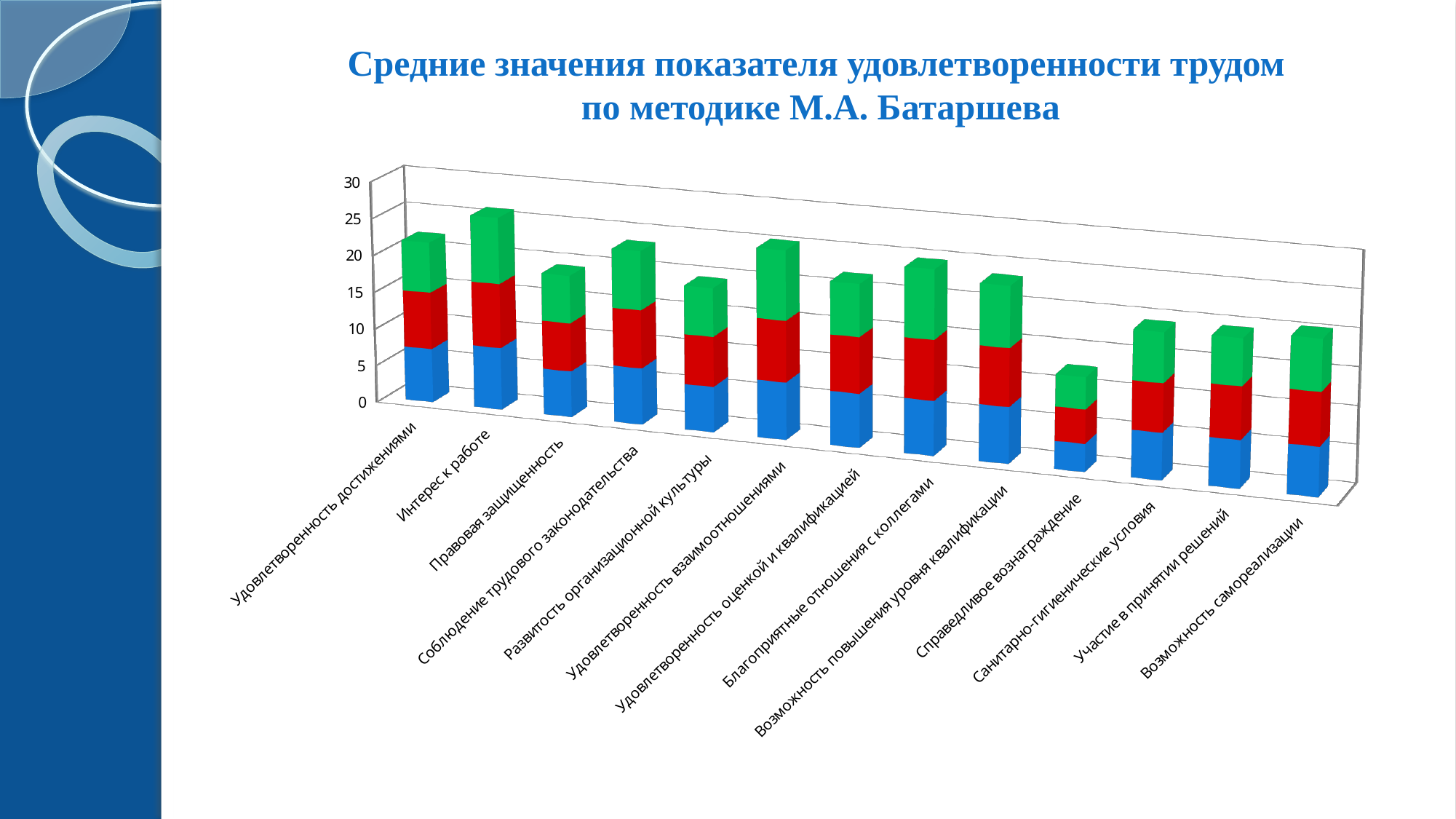
What is the title of the chart on the slide? Средние значения показателя удовлетворенности трудом по методике М.А. Батаршева Which bar is taller: Интерес к работе or Правовая защищенность? Интерес к работе How many coloured segments make up each stacked bar in the chart? 3 Is the total bar height for Справедливое вознаграждение greater or less than 20? less Is the total bar height for Удовлетворенность достижениями greater or less than 15? greater Which bar is taller: Интерес к работе or Справедливое вознаграждение? Интерес к работе How many categories are plotted along the x axis of the chart? 13 What kind of chart is shown on the slide? bar chart Is the total bar height for Интерес к работе greater or less than 20? greater Which category has the shortest bar in the chart? Справедливое вознаграждение Which category has the tallest bar in the chart? Интерес к работе